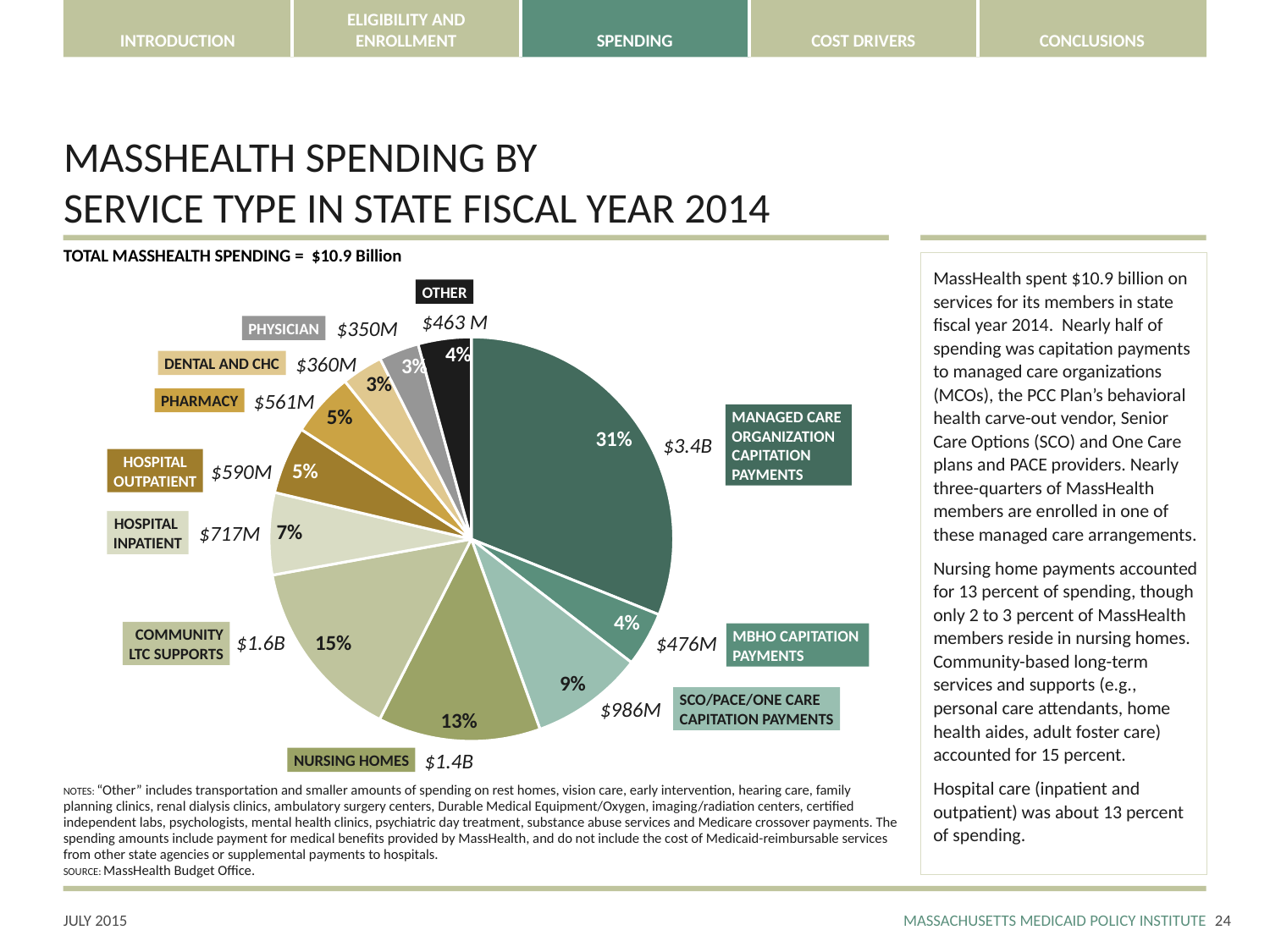
What was the spending amount for SCO/PACE/One Care Capitation Payments? $986M How many service type categories are shown in the pie chart? 11 What share of spending went to Community LTC Supports? 15% Which service type accounted for the largest share of MassHealth spending? Managed Care Organization Capitation Payments What was the spending amount for Other? $463 M What is the difference in spending between Hospital Inpatient ($717M) and Hospital Outpatient ($590M)? $127M What share of MassHealth spending went to Managed Care Organization Capitation Payments? 31% What share of spending went to MBHO Capitation Payments? 4% What was the spending amount for Nursing Homes? $1.4B What type of chart is shown on the slide? pie chart Which is larger, spending on Hospital Inpatient or Hospital Outpatient? Hospital Inpatient What total MassHealth spending figure is stated above the chart? $10.9 Billion